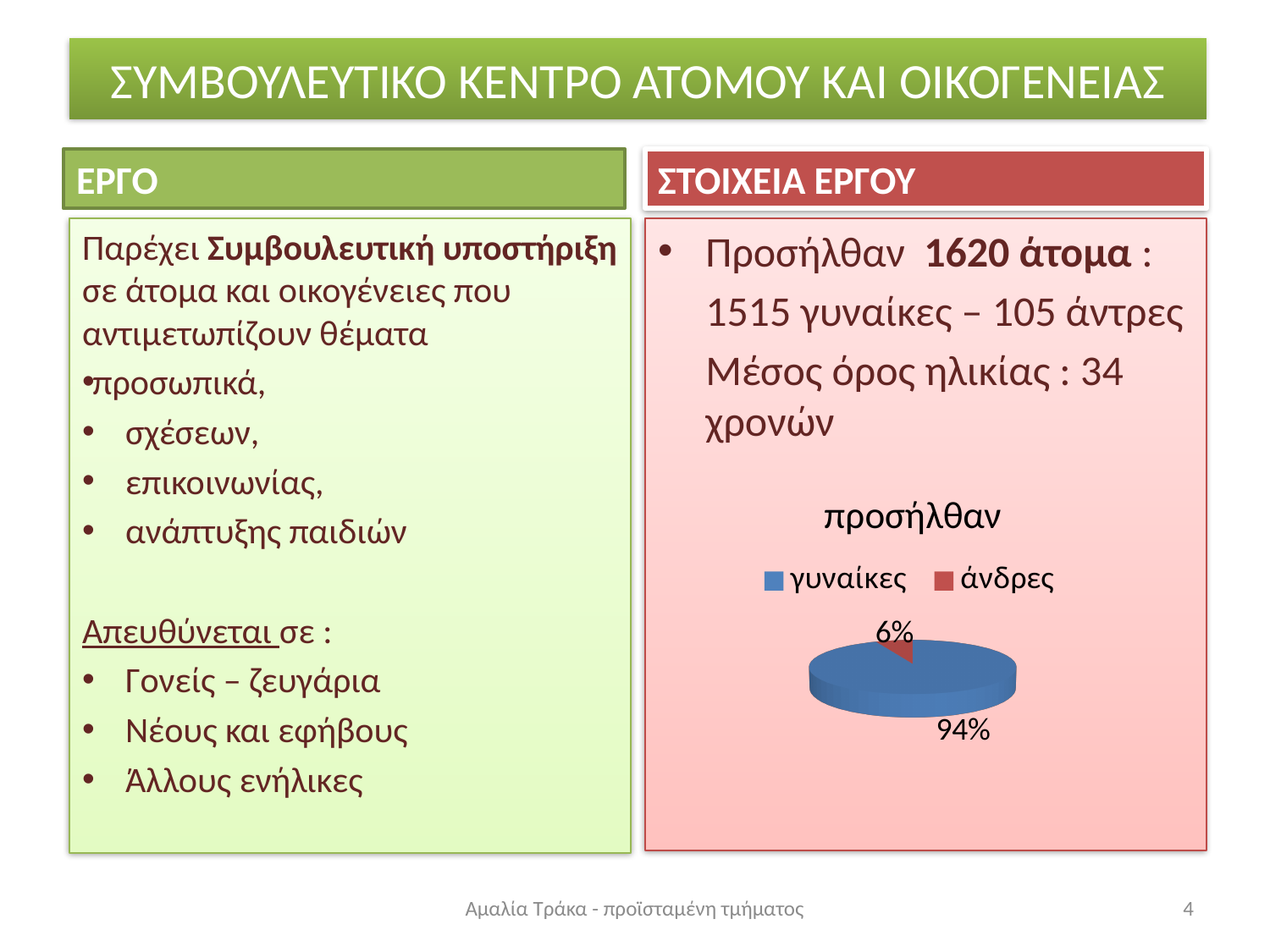
How many categories does the pie chart show? 2 What share of the pie does γυναίκες represent? 94% What is the title of the chart? προσήλθαν Which category has the smallest slice of the pie? άνδρες Which is larger, the slice for γυναίκες or the slice for άνδρες? γυναίκες Which category has the largest slice of the pie? γυναίκες What share of the pie does άνδρες represent? 6% What is the difference in percentage points between the γυναίκες slice and the άνδρες slice? 88 How many entries does the legend list? 2 Which colour represents άνδρες in the pie chart? red What kind of chart is shown on the slide? pie chart